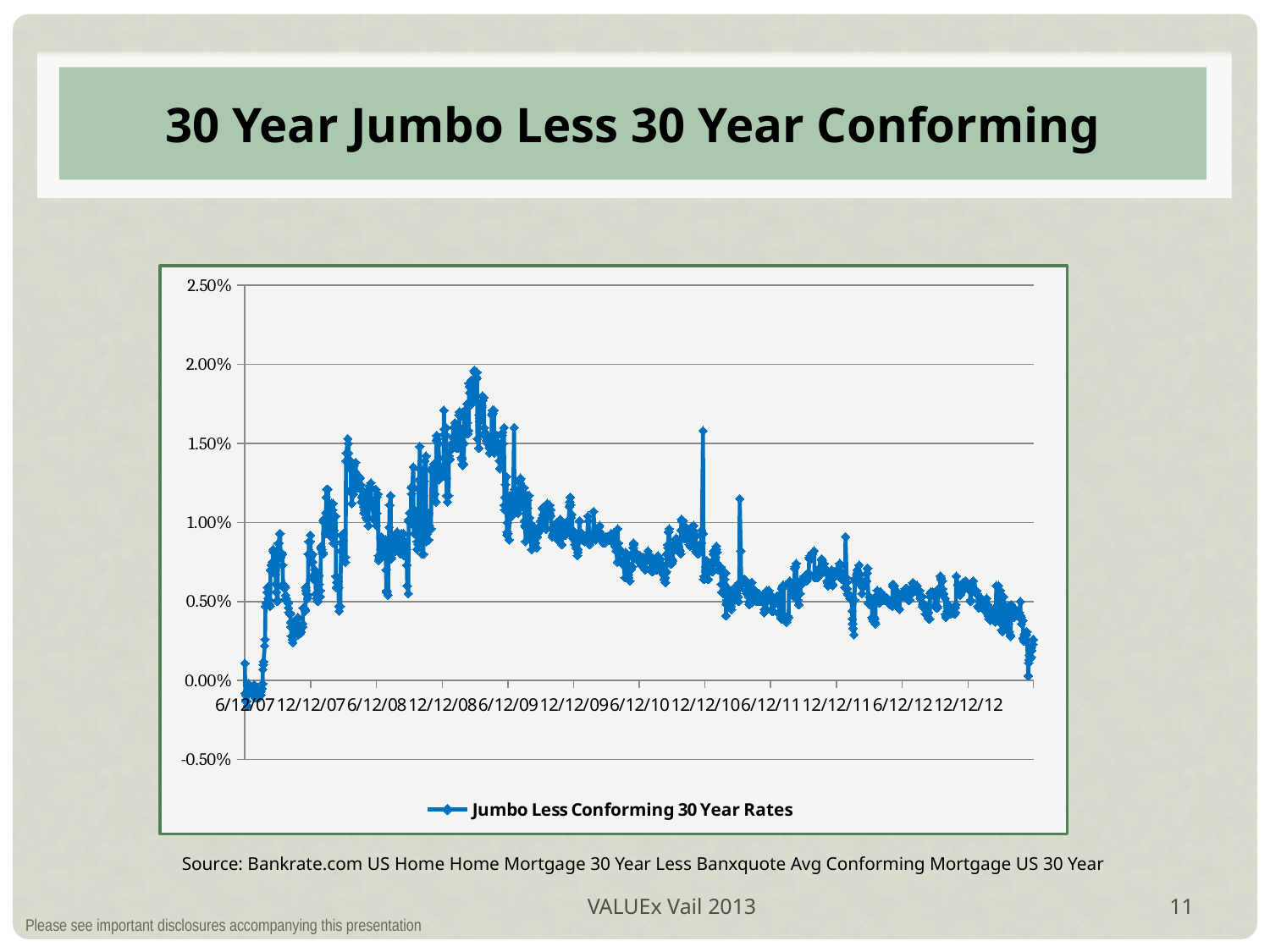
What kind of chart is shown on the slide? line chart Is the value for 6/12/11 greater or less than 1.00%? less Is the highest value reached by the series greater or less than 1.50%? greater Does the series generally rise or fall between 6/12/07 and 6/12/09? rise What is the title of the chart? 30 Year Jumbo Less 30 Year Conforming Is the value at the far right end of the series greater or less than 0.50%? less How many series does the legend list? 1 How many date labels are shown on the x axis? 12 Does the series generally rise or fall between 6/12/09 and 12/12/12? fall What is the legend entry for the plotted series? Jumbo Less Conforming 30 Year Rates